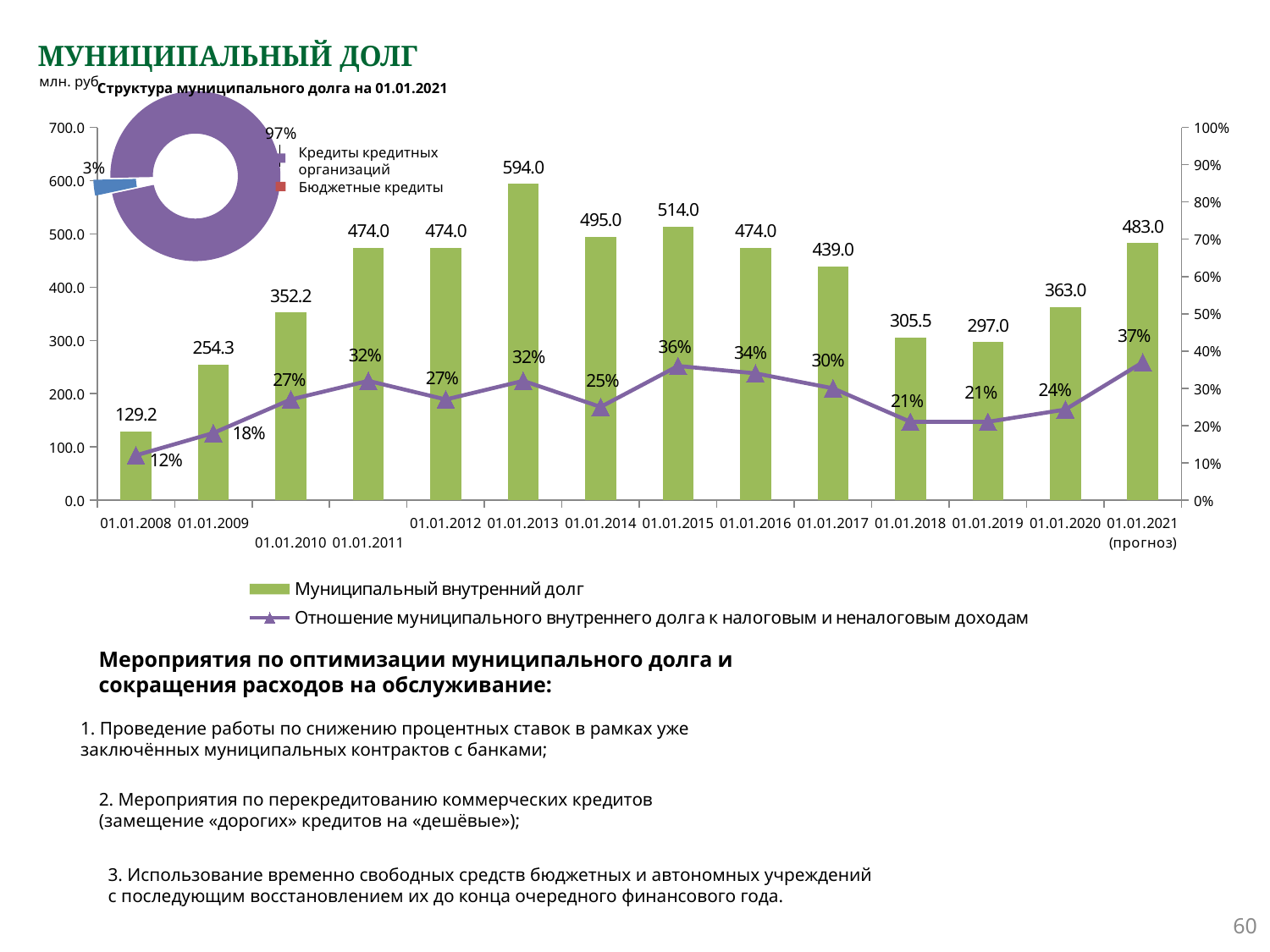
On the main bar-and-line chart, how many series does the legend list? 2 On the main bar-and-line chart, which date has the lowest value of Муниципальный внутренний долг? 01.01.2008 What kind of chart is the small chart titled Структура муниципального долга на 01.01.2021? Donut (pie) chart On the main bar-and-line chart, how many dates are shown on the x axis? 14 On the main bar-and-line chart, what is the value of Муниципальный внутренний долг for 01.01.2013? 594.0 On the main bar-and-line chart, what is the lowest ratio value shown on the line series? 12% On the main bar-and-line chart, what is the value of Муниципальный внутренний долг for 01.01.2008? 129.2 On the main bar-and-line chart, what is the ratio of municipal internal debt to tax and non-tax revenues shown for 01.01.2021 (прогноз)? 37% On the chart titled Структура муниципального долга на 01.01.2021, what share is Кредиты кредитных организаций? 97% On the main bar-and-line chart, which is larger: the Муниципальный внутренний долг value for 01.01.2020 or for 01.01.2021 (прогноз)? 01.01.2021 (прогноз) On the main bar-and-line chart, which date has the highest value of Муниципальный внутренний долг? 01.01.2013 On the main bar-and-line chart, what is the difference between the Муниципальный внутренний долг values for 01.01.2013 and 01.01.2014? 99.0